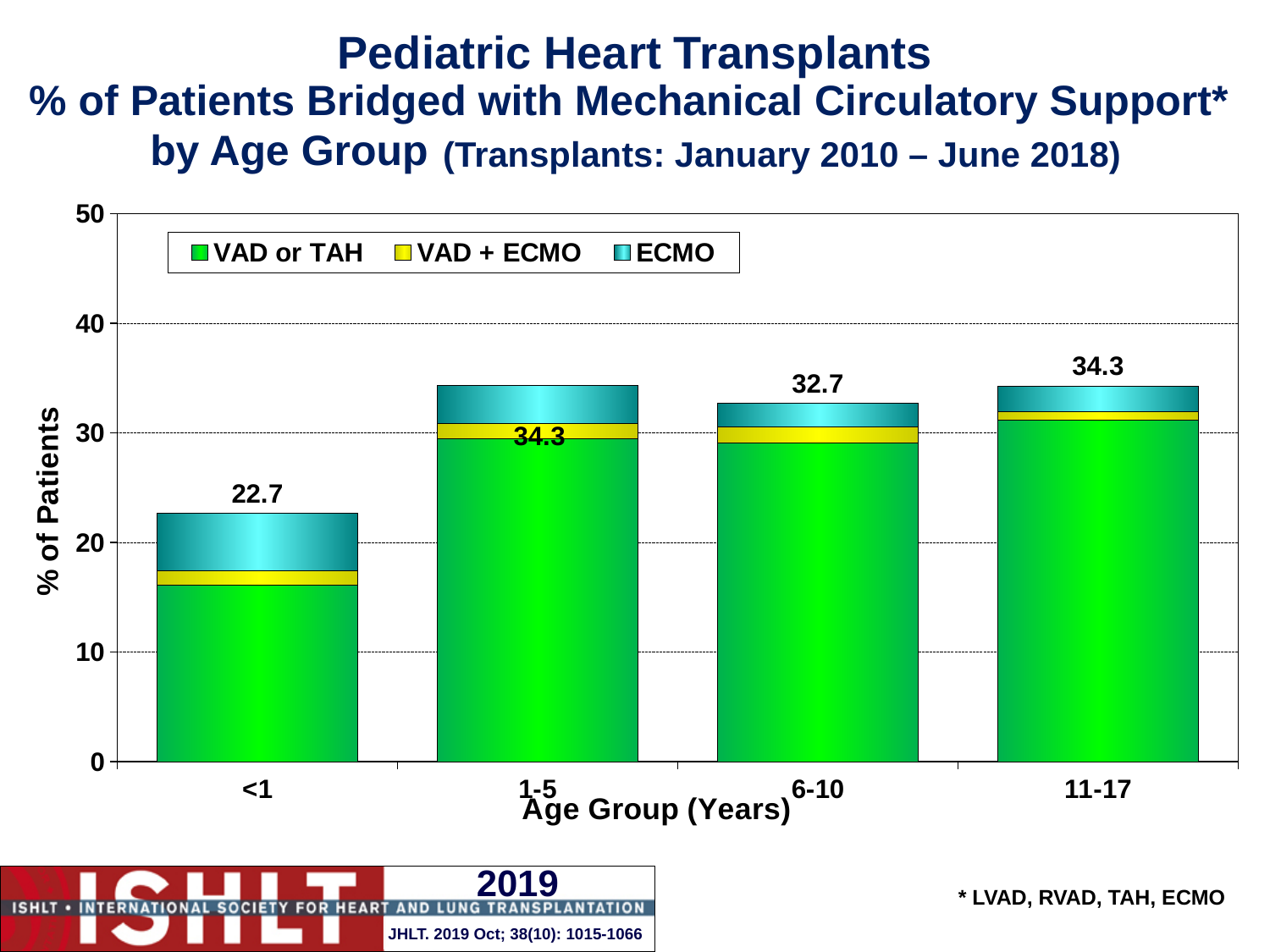
What kind of chart is shown on the slide? Stacked bar chart Is the VAD or TAH value for the 11-17 age group greater or less than 20? greater What is the total value shown for the 11-17 age group? 34.3 Is the VAD or TAH value for the <1 age group greater or less than 20? less Which age group has the lowest total percentage of patients bridged with mechanical circulatory support? <1 What is the total value shown for the 6-10 age group? 32.7 What is the difference between the total for the 1-5 age group and the total for the <1 age group? 11.6 How many age groups are shown on the x axis? 4 What is the total percentage of patients bridged with mechanical circulatory support for the <1 age group? 22.7 Which has a larger total percentage, the 1-5 age group or the 6-10 age group? 1-5 What is the difference between the total for the 11-17 age group and the total for the 6-10 age group? 1.6 How many series does the legend list? 3